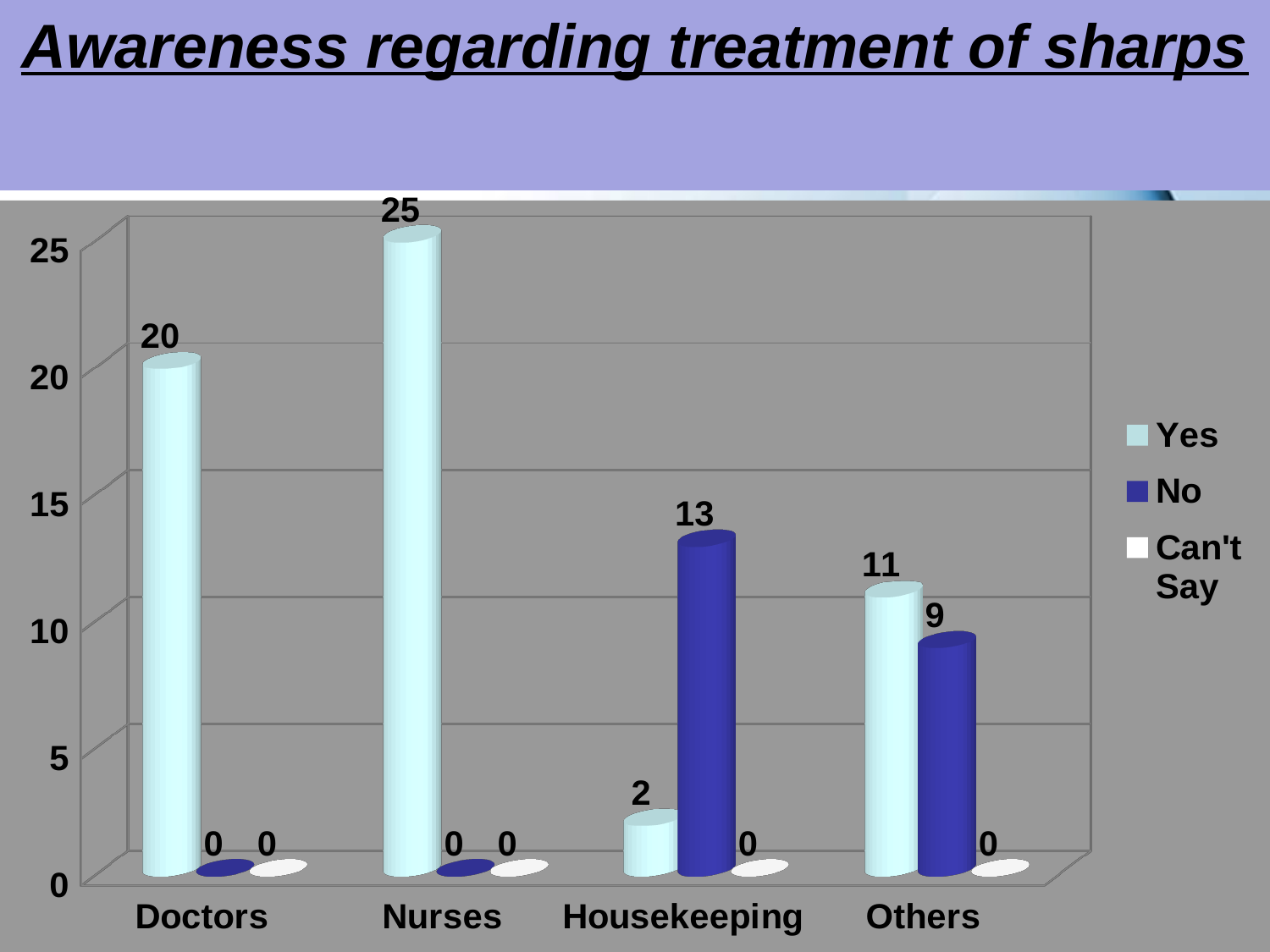
What is the title of the slide? Awareness regarding treatment of sharps What is the value for Can't Say among Doctors? 0 Which category has the highest Yes value? Nurses What kind of chart is shown on the slide? Bar chart Which category has the lowest Yes value? Housekeeping What is the value for Yes among Others? 11 Which is larger for Others, the Yes value or the No value? Yes What is the difference between the Yes values for Nurses and Doctors? 5 What is the value for Yes among Nurses? 25 How many series does the legend list? 3 What is the value for No among Housekeeping? 13 How many categories are shown on the x axis? 4